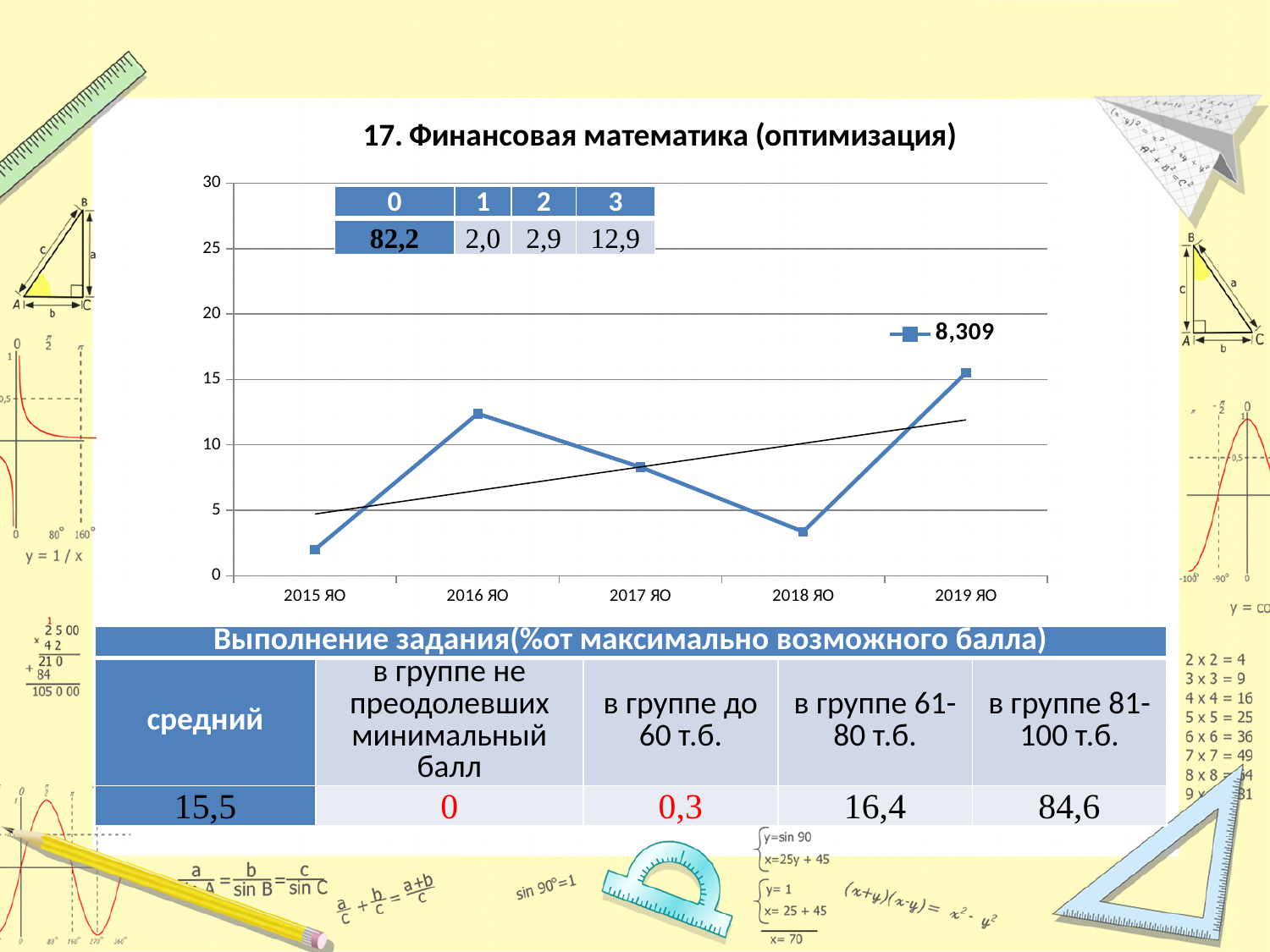
Is the value for 2015 ЯО greater or less than 5? less What label does the legend show for the plotted series? 8,309 Does the value rise or fall from 2018 ЯО to 2019 ЯО? rise How many categories are shown on the x axis of the chart? 5 Which is larger, the value for 2016 ЯО or the value for 2018 ЯО? 2016 ЯО Is the value for 2018 ЯО greater or less than 5? less What kind of chart is shown on the slide? line chart Which year has the highest value on the chart? 2019 ЯО Is the value for 2016 ЯО greater or less than 10? greater How many series does the chart legend list? 1 What is the title of the chart? 17. Финансовая математика (оптимизация) Which year has the lowest value on the chart? 2015 ЯО